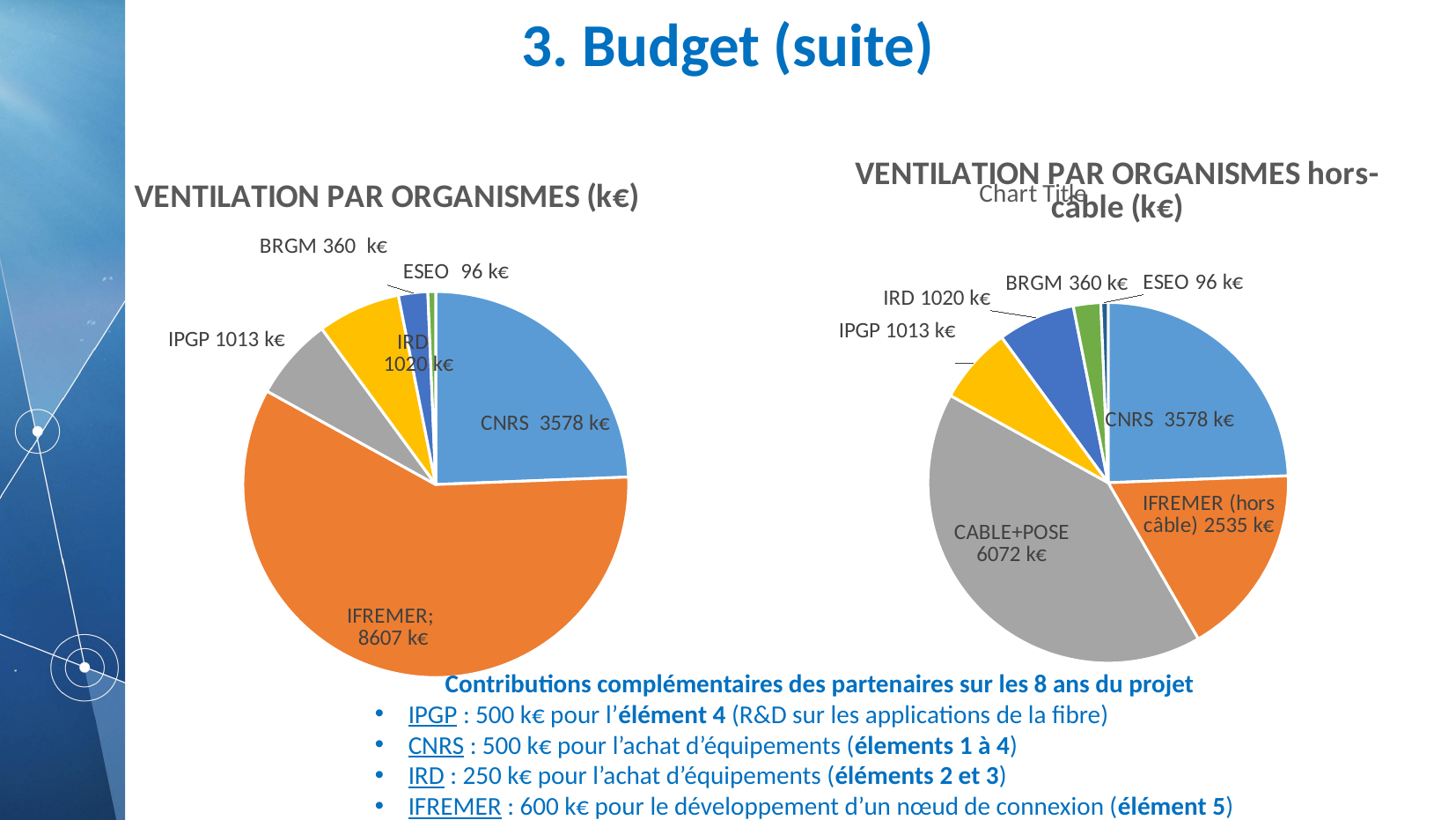
In the left pie chart (VENTILATION PAR ORGANISMES), what is the value for IFREMER? 8607 k€ In the right pie chart (hors-câble), what is the value for IFREMER (hors câble)? 2535 k€ How many slices does the left pie chart (VENTILATION PAR ORGANISMES) have? 6 In the right pie chart (hors-câble), what is the value for CABLE+POSE? 6072 k€ In the left pie chart (VENTILATION PAR ORGANISMES), which organisation has the largest slice? IFREMER What type of chart is used for VENTILATION PAR ORGANISMES (k€) on the left? Pie chart In the left pie chart (VENTILATION PAR ORGANISMES), what is the value for CNRS? 3578 k€ In the right pie chart (hors-câble), which category has the smallest slice? ESEO In the right pie chart (hors-câble), what is the difference between the CABLE+POSE and CNRS values? 2494 k€ In the left pie chart (VENTILATION PAR ORGANISMES), what is the difference between the IFREMER and CNRS values? 5029 k€ In the right pie chart (hors-câble), which is larger, CABLE+POSE or IFREMER (hors câble)? CABLE+POSE How many slices does the right pie chart (hors-câble) have? 7